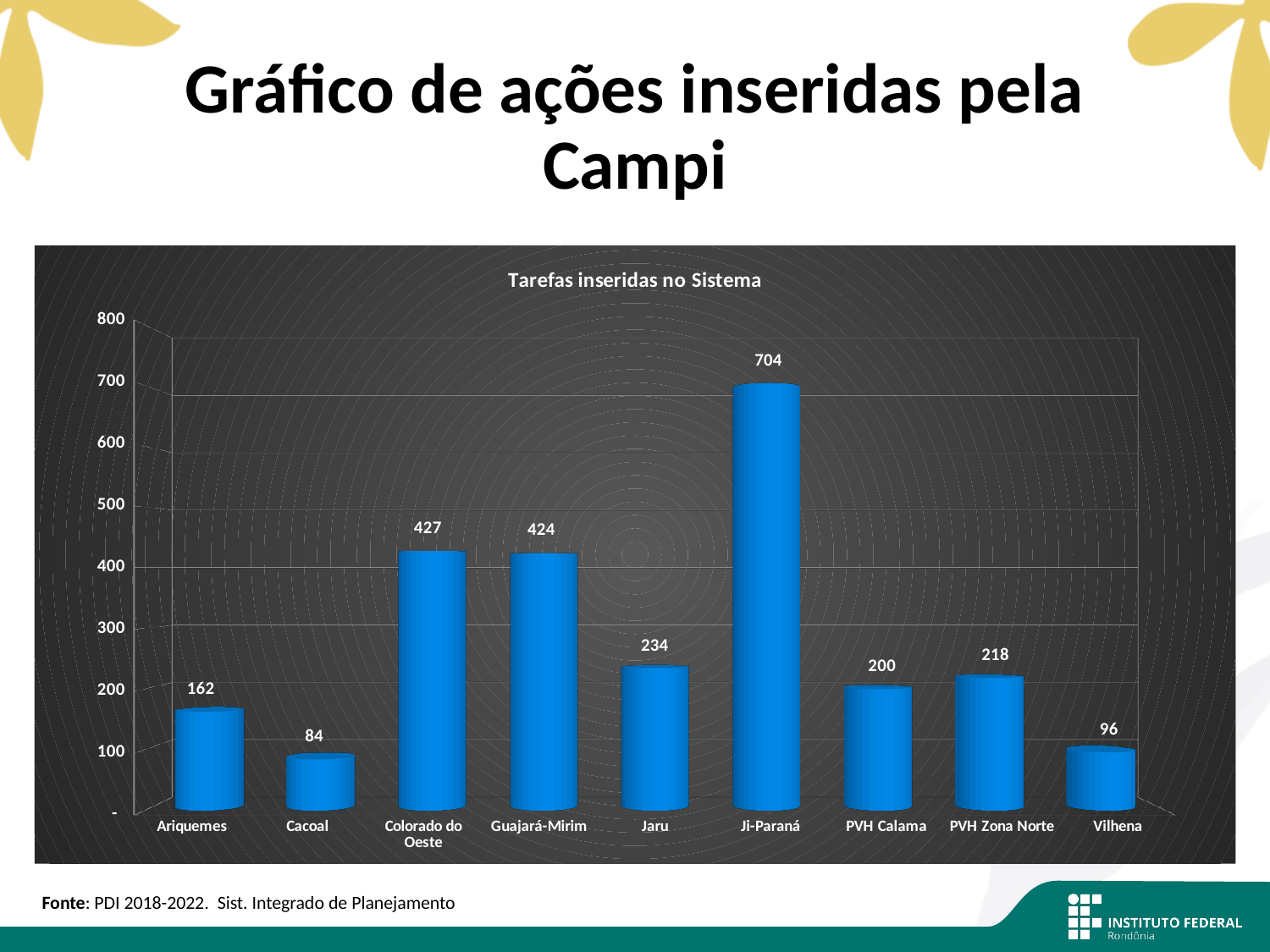
Which campus has the lowest number of tasks inserted? Cacoal What kind of chart is shown on the slide? bar chart How many campuses are shown on the x axis? 9 What is the difference between the values for Ji-Paraná and Colorado do Oeste? 277 What is the title of the chart? Tarefas inseridas no Sistema What is the difference between the values for Jaru and PVH Calama? 34 What is the value for Cacoal? 84 Is the value for Guajará-Mirim greater or less than 400? greater What is the value for PVH Zona Norte? 218 Which campus has the highest number of tasks inserted? Ji-Paraná Which is larger, the value for Ariquemes or the value for Vilhena? Ariquemes What is the value for Ji-Paraná? 704